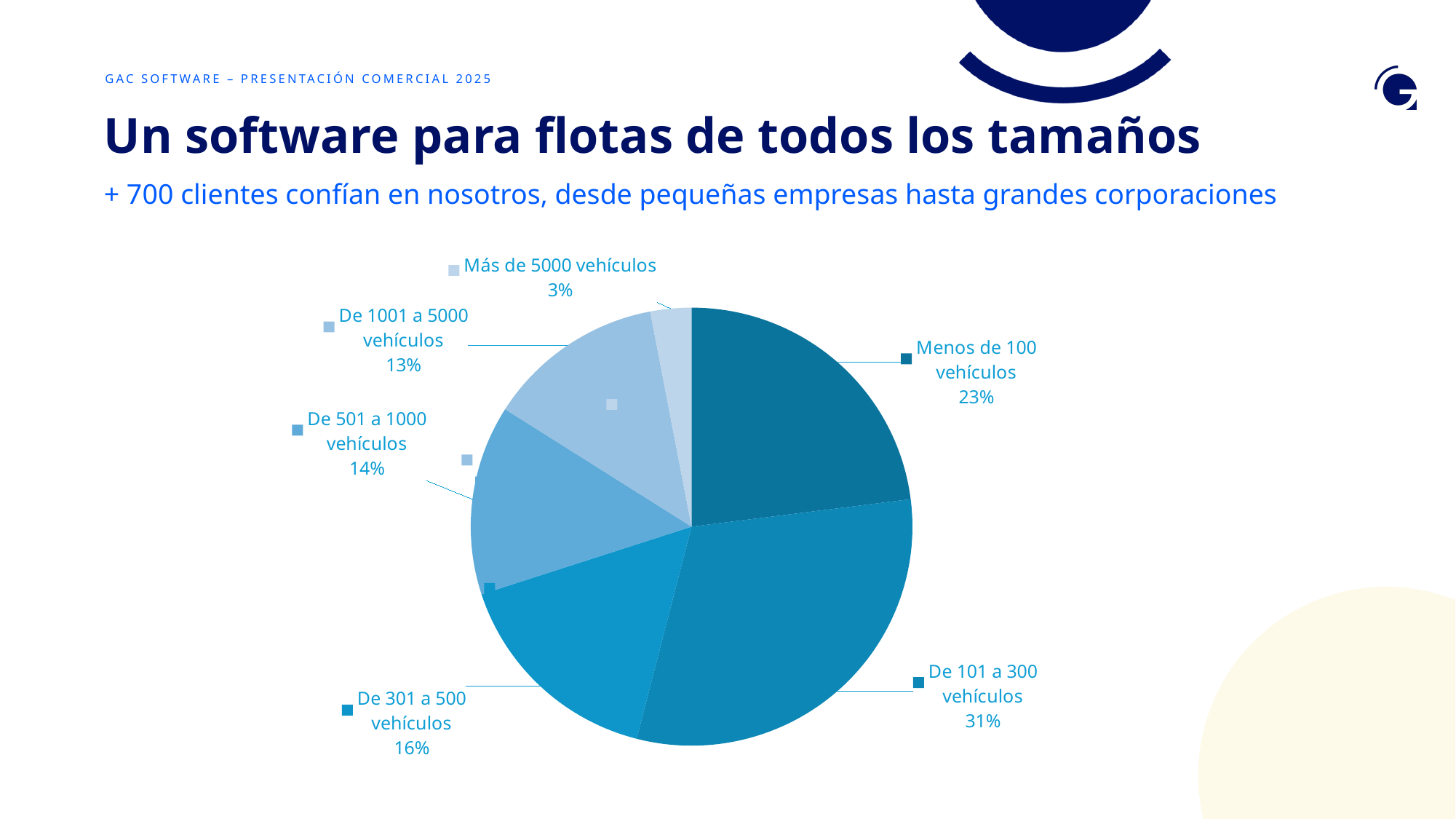
Which category has the smallest slice of the pie? Más de 5000 vehículos What kind of chart is shown on the slide? pie chart Which category has the largest slice of the pie? De 101 a 300 vehículos Which is larger, the share for 'De 1001 a 5000 vehículos' or for 'De 301 a 500 vehículos'? De 301 a 500 vehículos What is the value for 'De 501 a 1000 vehículos'? 14% What is the value for 'Más de 5000 vehículos'? 3% How many slices does the pie chart have? 6 What is the difference between the shares of 'De 101 a 300 vehículos' and 'Menos de 100 vehículos'? 8% What is the combined share of 'De 501 a 1000 vehículos' and 'De 1001 a 5000 vehículos'? 27% What share of the pie is 'Menos de 100 vehículos'? 23% What is the value for 'De 301 a 500 vehículos'? 16% What share of the pie is 'De 101 a 300 vehículos'? 31%